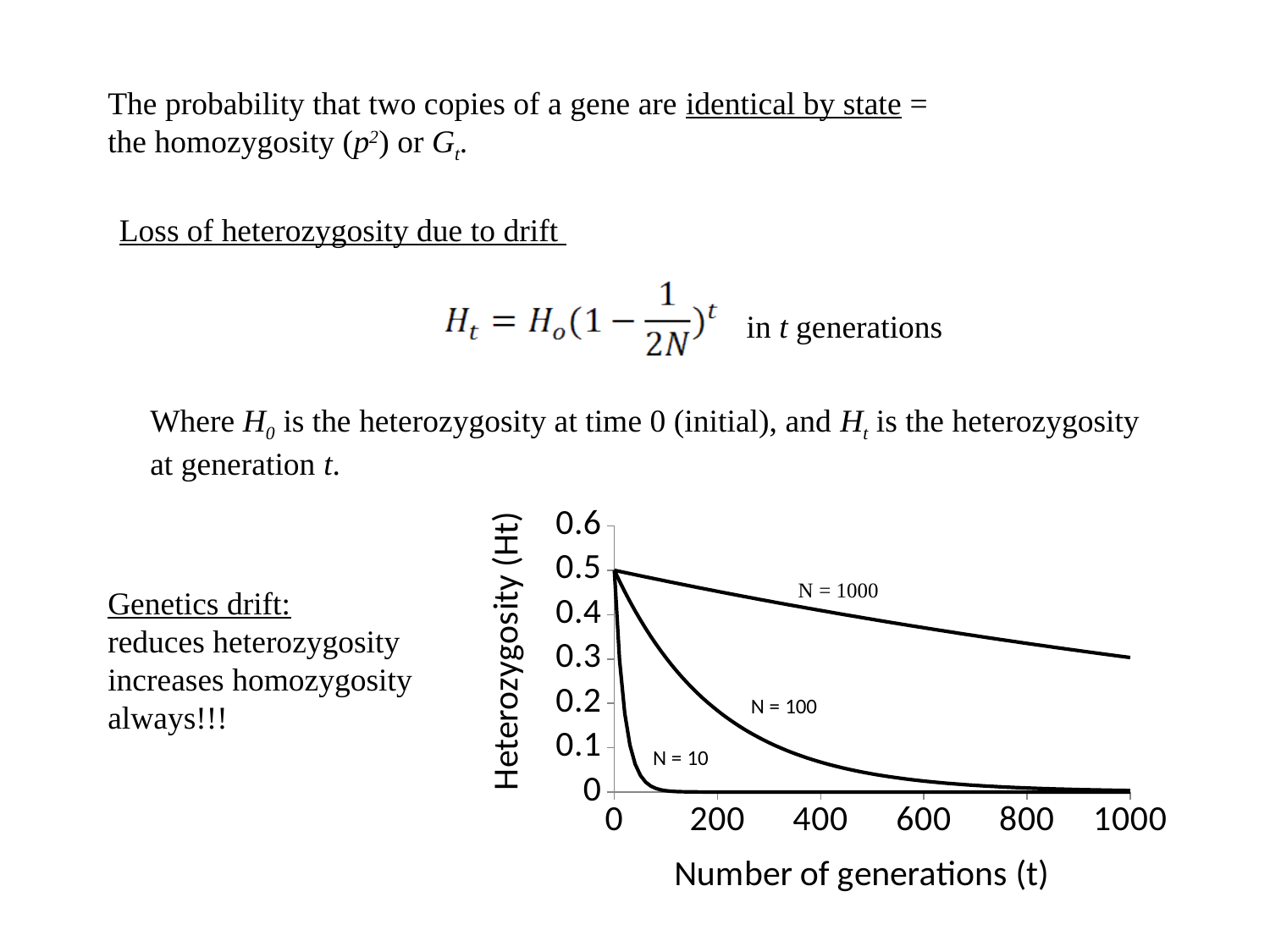
Is the heterozygosity for N = 100 at 400 generations greater or less than 0.1? less What is the label of the x axis of the chart? Number of generations (t) What is the heterozygosity value at which all three curves start at generation 0? 0.5 How many curves are plotted on the chart? 3 Which curve retains the highest heterozygosity at 1000 generations? N = 1000 Which curve declines most rapidly with the number of generations? N = 10 Is the heterozygosity for N = 10 at 200 generations greater or less than 0.1? less Is the heterozygosity for N = 1000 at 200 generations greater or less than 0.4? greater What is the label of the y axis of the chart? Heterozygosity (Ht) At 400 generations, which curve has the higher heterozygosity, N = 1000 or N = 100? N = 1000 What kind of chart is shown on the slide? line chart Do the heterozygosity values rise or fall as the number of generations increases? fall